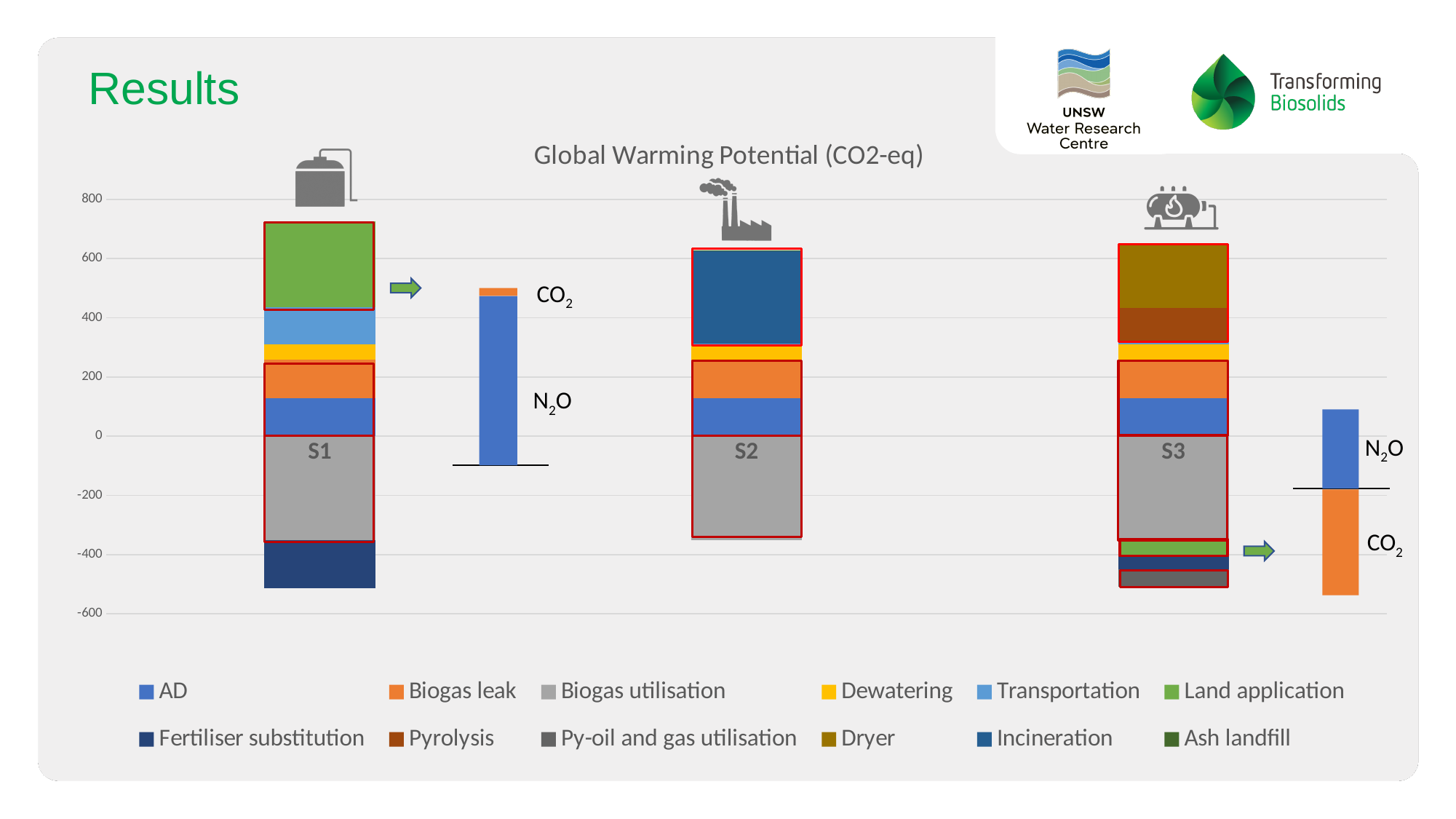
How many scenarios (categories) are plotted on the x axis of the chart? 3 How many series does the chart legend list? 12 Is the top of the positive stack for S2 greater or less than 400? greater What is the title of the chart? Global Warming Potential (CO2-eq) Is the bottom of the negative stack for S3 greater or less than -400? less Is the bottom of the negative stack for S1 greater or less than -400? less What kind of chart is shown on the slide? Stacked bar chart Which scenario's negative stack extends the least far below zero? S2 Which colour represents Land application in the legend? Green Which scenario has the highest top of its positive stack? S1